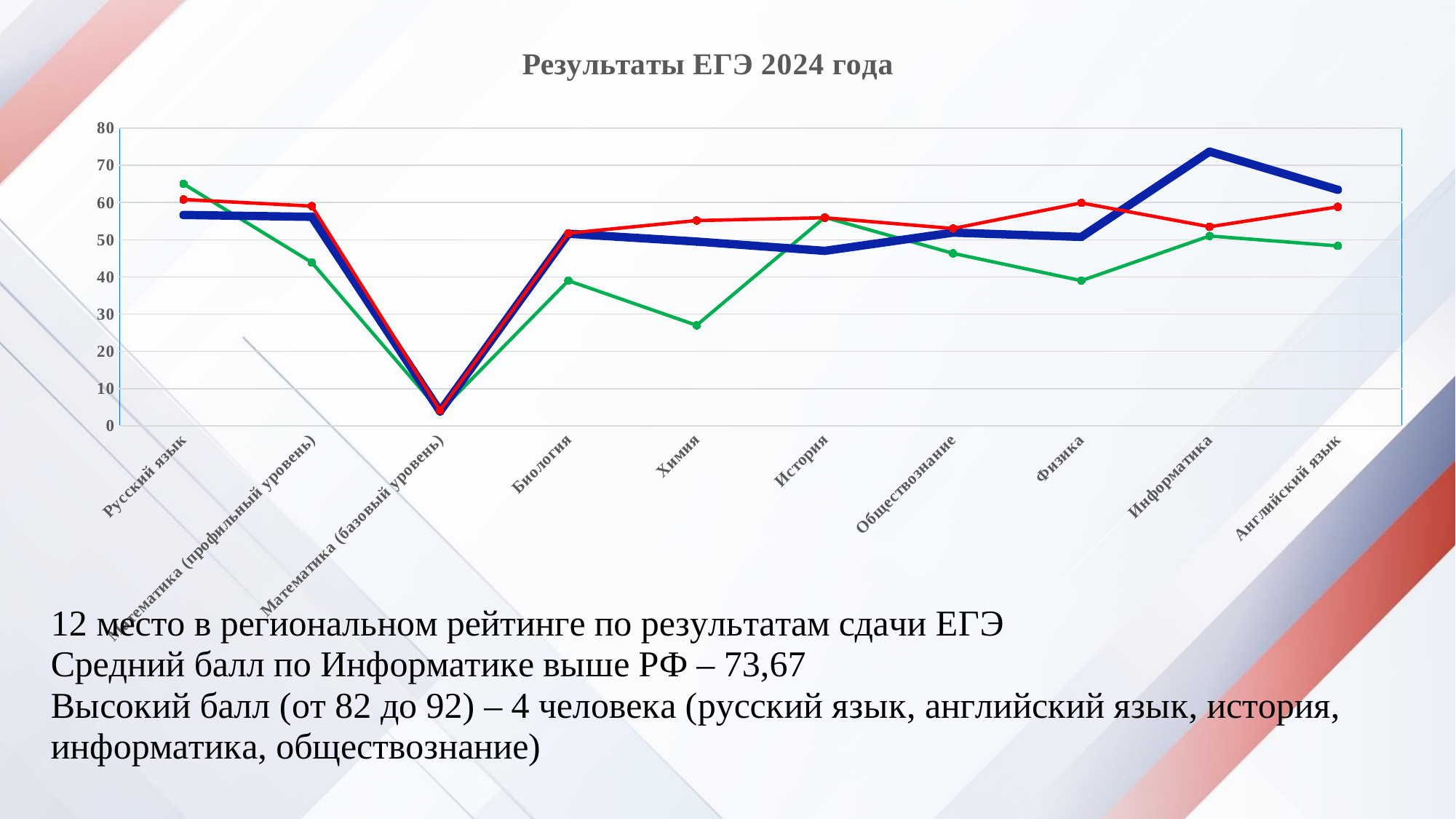
How many lines are plotted on the chart? 3 For which subject does the thick blue line reach its highest value? Информатика For which subject does the thick blue line reach its lowest value? Математика (базовый уровень) For Русский язык, which line has the larger value: the green line or the red line? the green line How many subjects (categories) are shown on the x axis of the chart? 10 Is the value of the thick blue line for Математика (базовый уровень) greater or less than 10? less Is the value of the thick blue line for Информатика greater or less than 70? greater Is the value of the green line for Химия greater or less than 30? less What is the title of the chart? Результаты ЕГЭ 2024 года For Химия, which line has the larger value: the thick blue line or the green line? the thick blue line For which subject does the green line reach its highest value? Русский язык What kind of chart is shown on the slide? line chart